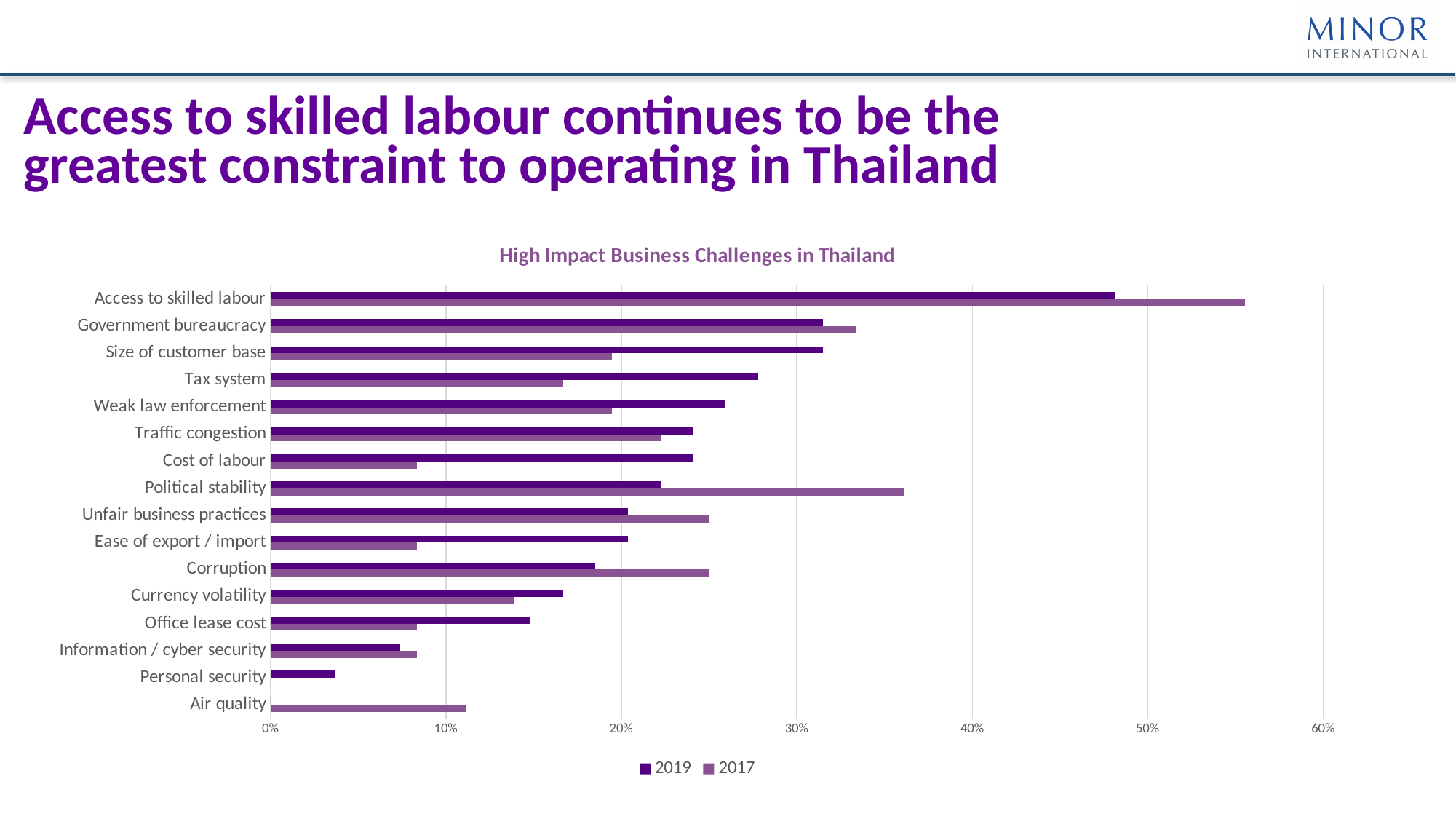
Is the 2017 value for Political stability greater or less than 30%? greater What is the title of the chart? High Impact Business Challenges in Thailand Is the 2017 value for Cost of labour greater or less than 10%? less For Size of customer base, which year has the larger value, 2019 or 2017? 2019 For Political stability, which year has the larger value, 2019 or 2017? 2017 Is the 2017 value for Access to skilled labour greater or less than 50%? greater How many business challenge categories are shown on the chart? 16 How many series does the legend list? 2 What kind of chart is shown on the slide? bar chart Which category has the highest value for 2017? Access to skilled labour Which category has the highest value for 2019? Access to skilled labour